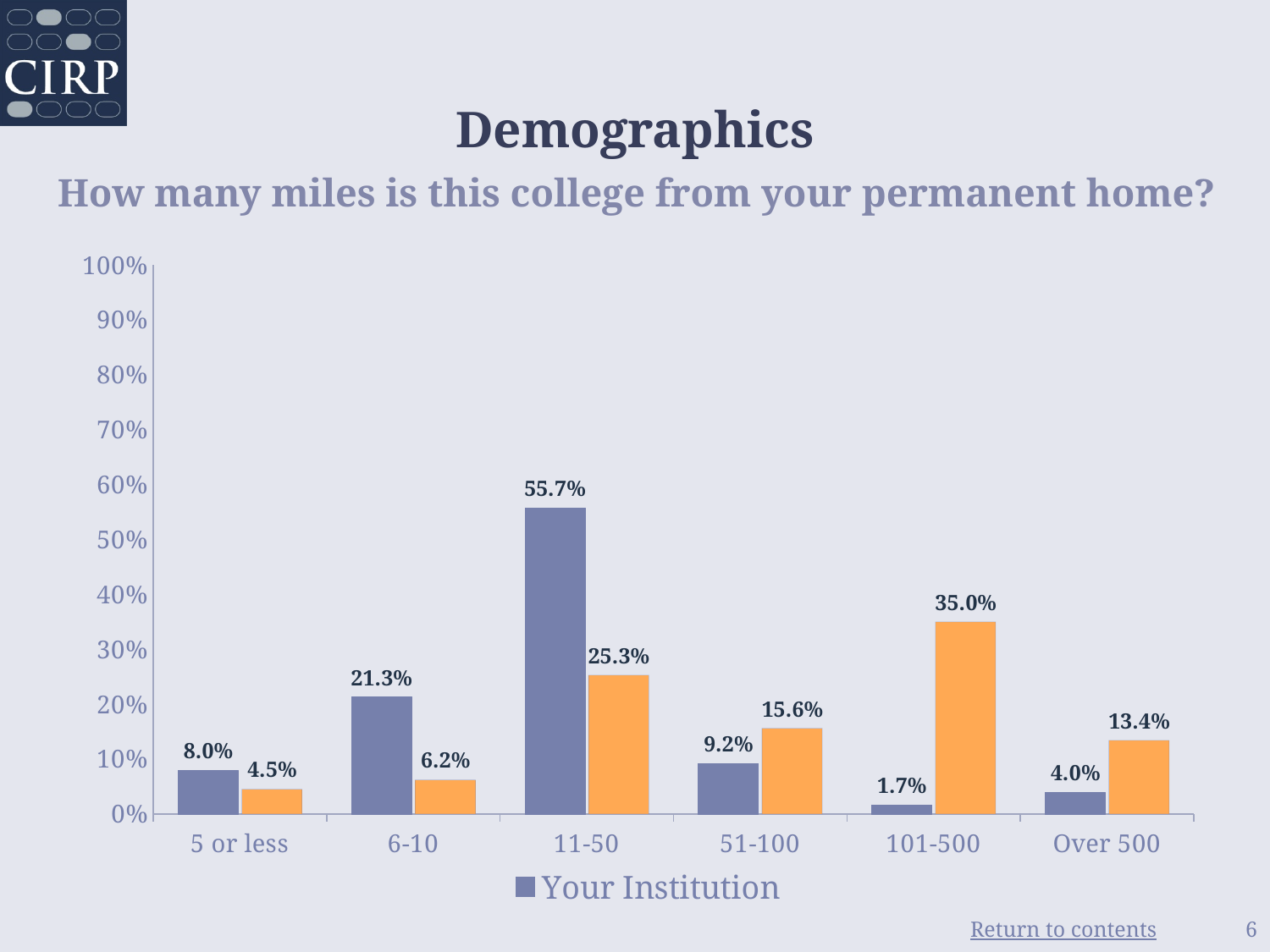
Which category has the highest value for Your Institution? 11-50 Which category has the lowest value for Your Institution? 101-500 What is the value for Your Institution in the 101-500 category? 1.7% What kind of chart is shown on the slide? bar chart What is the value for Your Institution in the 6-10 category? 21.3% Is the Your Institution value for 11-50 greater or less than 50%? greater How many series does the legend list? 1 What is the difference between the Your Institution values for 11-50 and 6-10? 34.4% How many categories are shown on the x axis? 6 For Your Institution, which is larger: the value for 5 or less or the value for 51-100? 51-100 What is the value for Your Institution in the 11-50 category? 55.7% What is the value for Your Institution in the Over 500 category? 4.0%